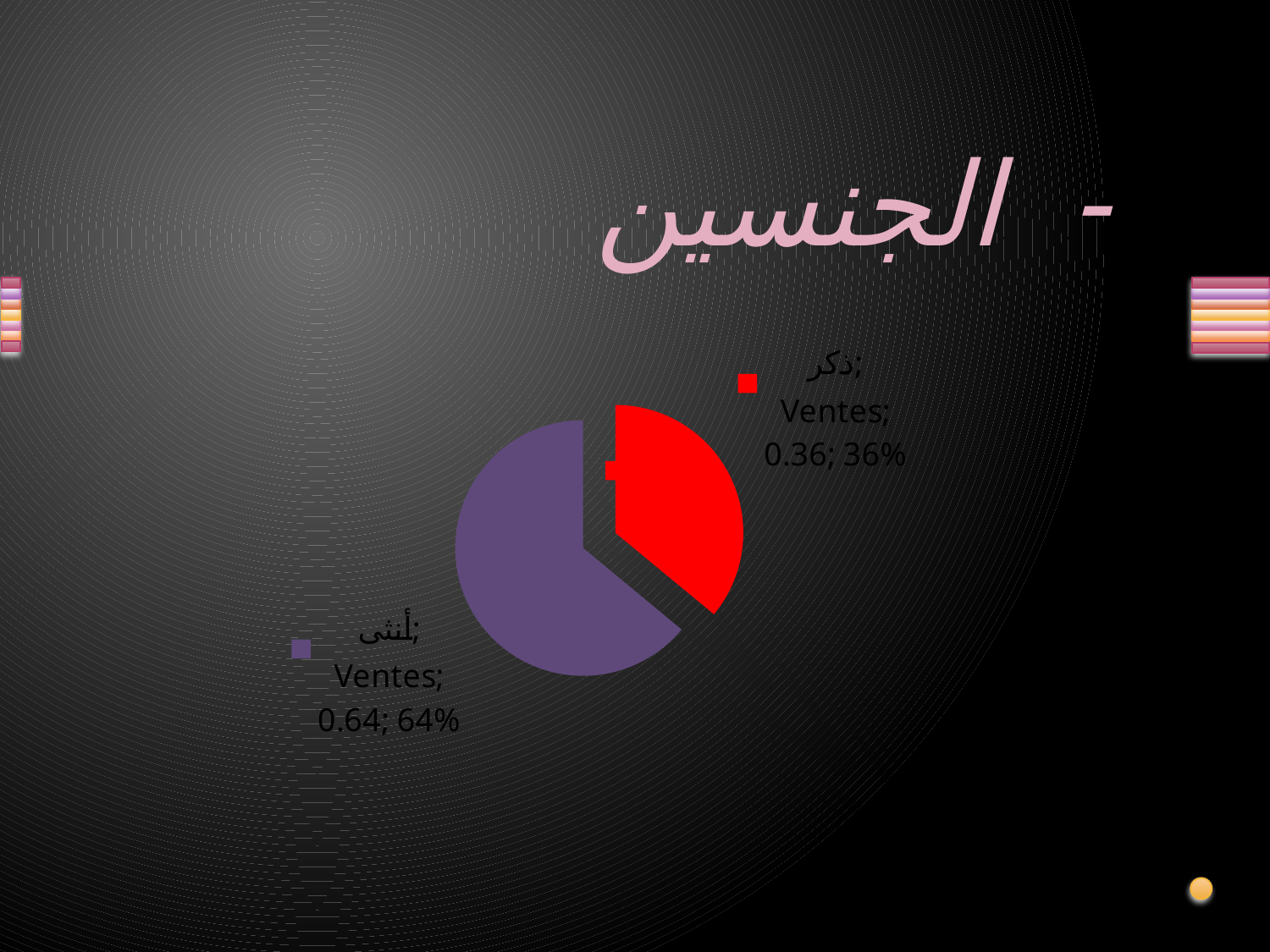
What percentage share does the ذكر slice have? 36% What value is printed for the أنثى slice? 0.64 Which slice is the smallest in the pie chart? ذكر What series name is printed in the data labels of the pie chart? Ventes What percentage share does the أنثى slice have? 64% What value is printed for the ذكر slice? 0.36 What colour is the ذكر slice? red How many slices does the pie chart have? 2 Which slice is the largest in the pie chart? أنثى What is the difference in percentage points between the أنثى slice and the ذكر slice? 28% Which is larger, the ذكر slice or the أنثى slice? أنثى What kind of chart is shown on the slide? pie chart